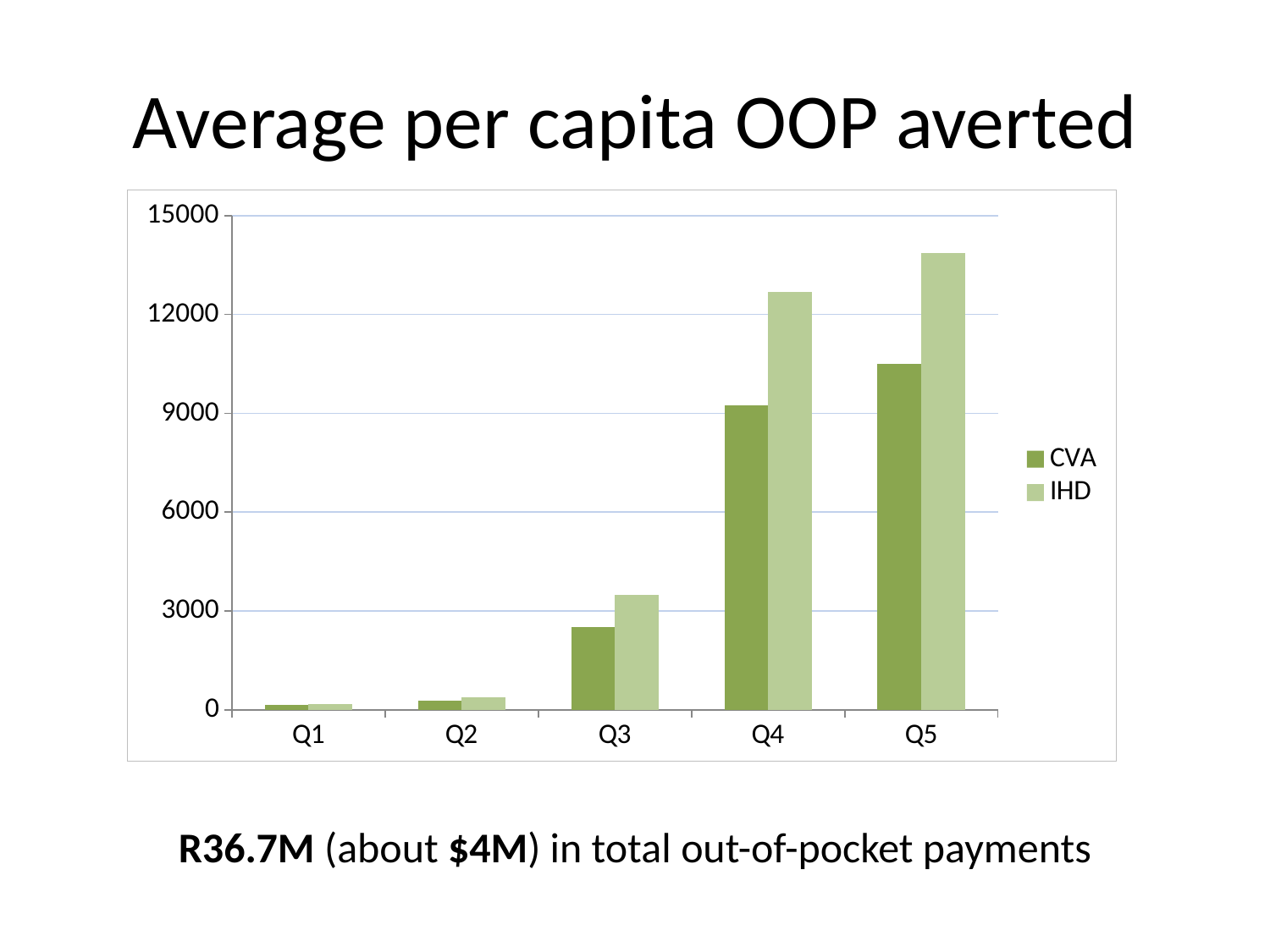
Which is larger for Q4, the CVA value or the IHD value? IHD What kind of chart is shown on the slide? bar chart Is the IHD value for Q3 greater or less than 3000? greater Which category has the highest IHD value? Q5 Do the CVA values rise or fall from Q1 to Q5? rise How many categories are shown on the x axis? 5 Is the CVA value for Q5 greater or less than 12000? less Is the CVA value for Q3 greater or less than 3000? less What is the title of the chart? Average per capita OOP averted How many series does the legend list? 2 Which category has the lowest CVA value? Q1